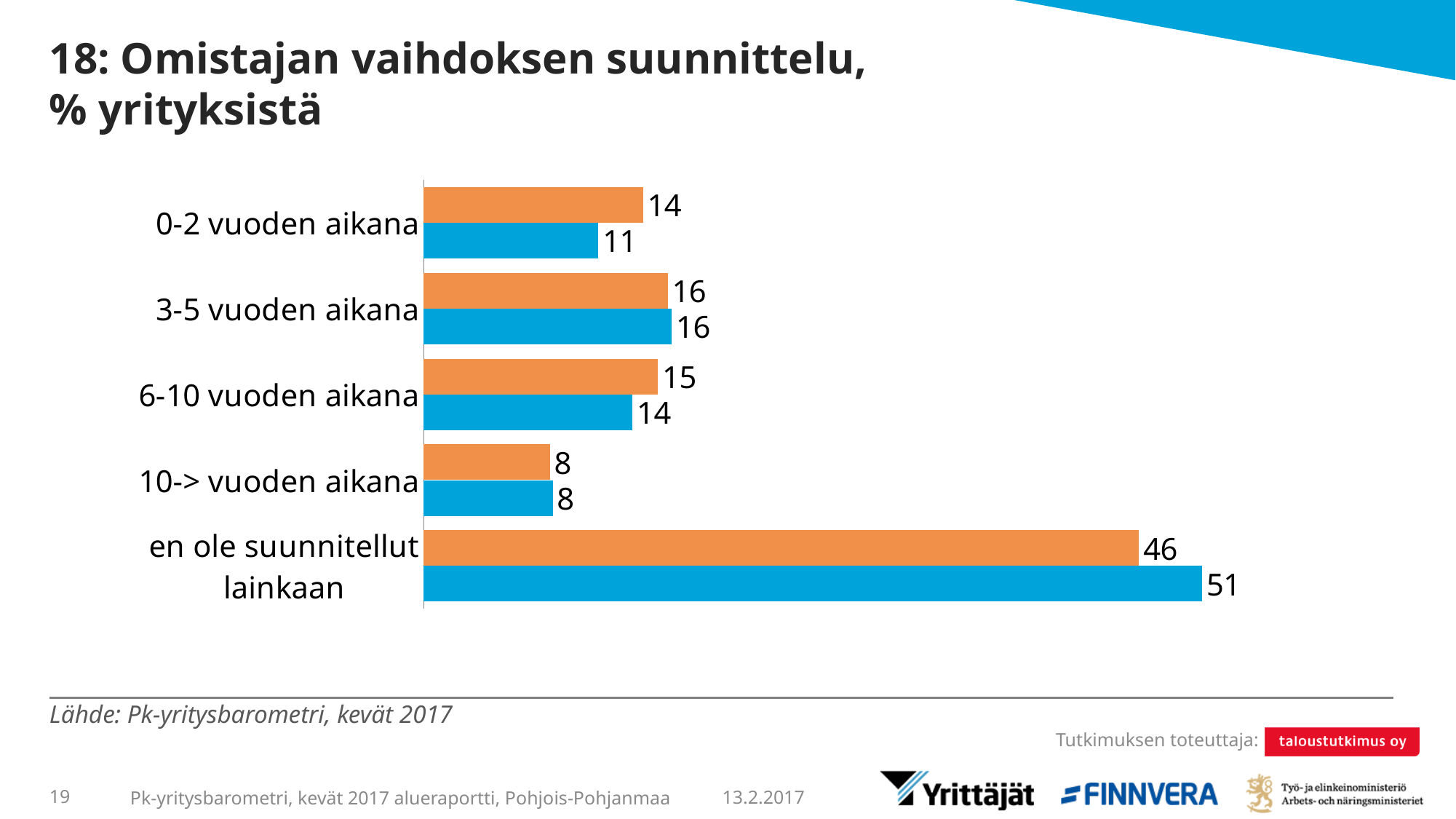
What kind of chart is shown on the slide? bar chart What is the difference between the orange and blue bars for "0-2 vuoden aikana"? 3 For "6-10 vuoden aikana", which is larger, the orange bar or the blue bar? the orange bar What is the value of the orange bar for "0-2 vuoden aikana"? 14 Which category has the lowest value for the orange bars? 10-> vuoden aikana What is the value of the blue bar for "0-2 vuoden aikana"? 11 What is the value of the orange bar for "6-10 vuoden aikana"? 15 Which category has the highest value for the blue bars? en ole suunnitellut lainkaan What is the value of the blue bar for "en ole suunnitellut lainkaan"? 51 How many categories are shown on the chart? 5 What is the title of the slide? 18: Omistajan vaihdoksen suunnittelu, % yrityksistä What is the difference between the blue and orange bars for "en ole suunnitellut lainkaan"? 5